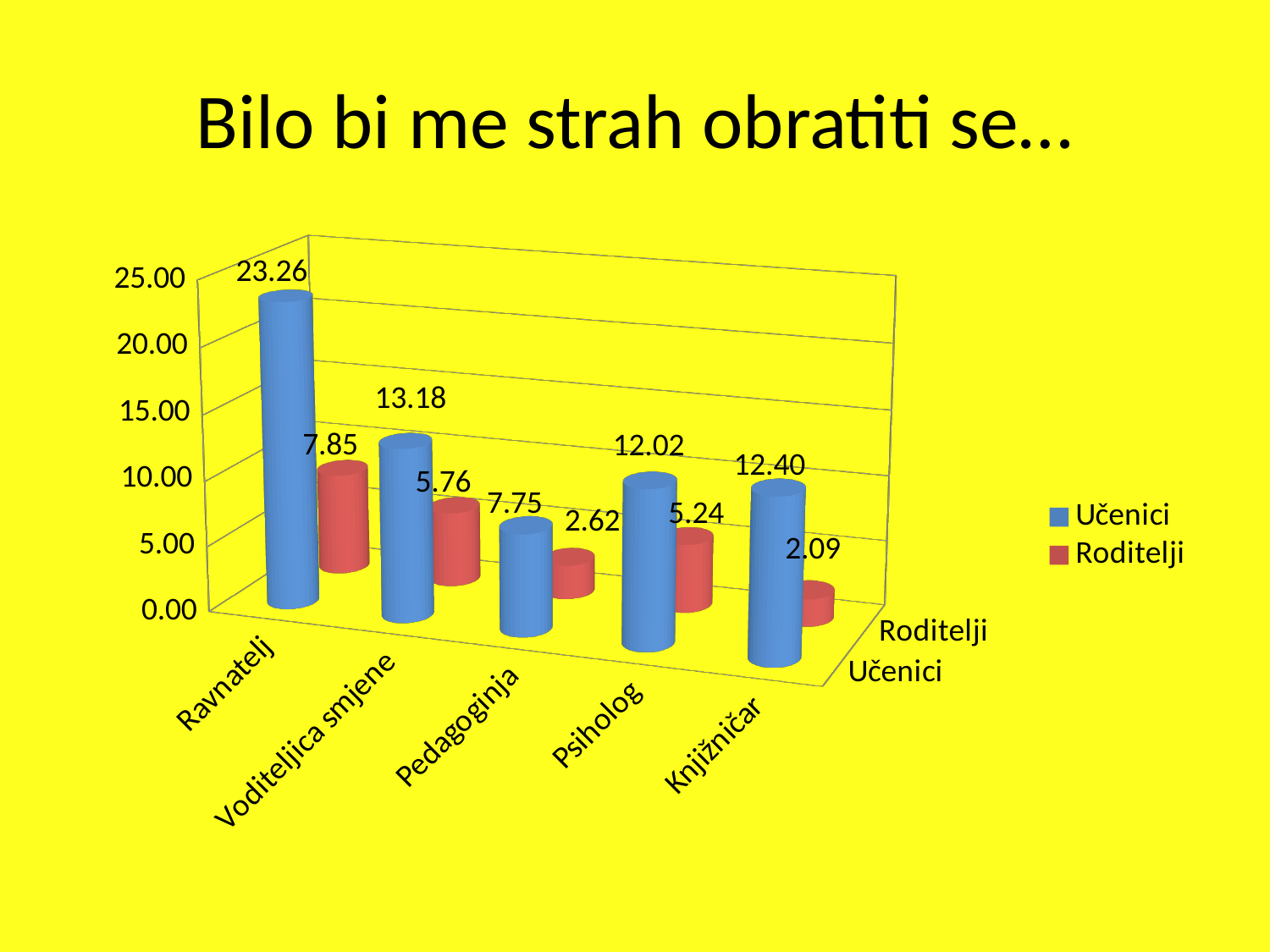
What is the Roditelji value for Knjižničar? 2.09 What kind of chart is shown on the slide? Bar chart What is the Roditelji value for Pedagoginja? 2.62 Which is larger, the Učenici value for Knjižničar or the Učenici value for Psiholog? Knjižničar What is the Učenici value for Psiholog? 12.02 How many series does the legend list? 2 Which category has the highest Učenici value? Ravnatelj What is the difference between the Učenici and Roditelji values for Voditeljica smjene? 7.42 What is the Učenici value for Ravnatelj? 23.26 What is the title of the slide? Bilo bi me strah obratiti se… How many categories are shown on the x axis? 5 Which category has the lowest Roditelji value? Knjižničar